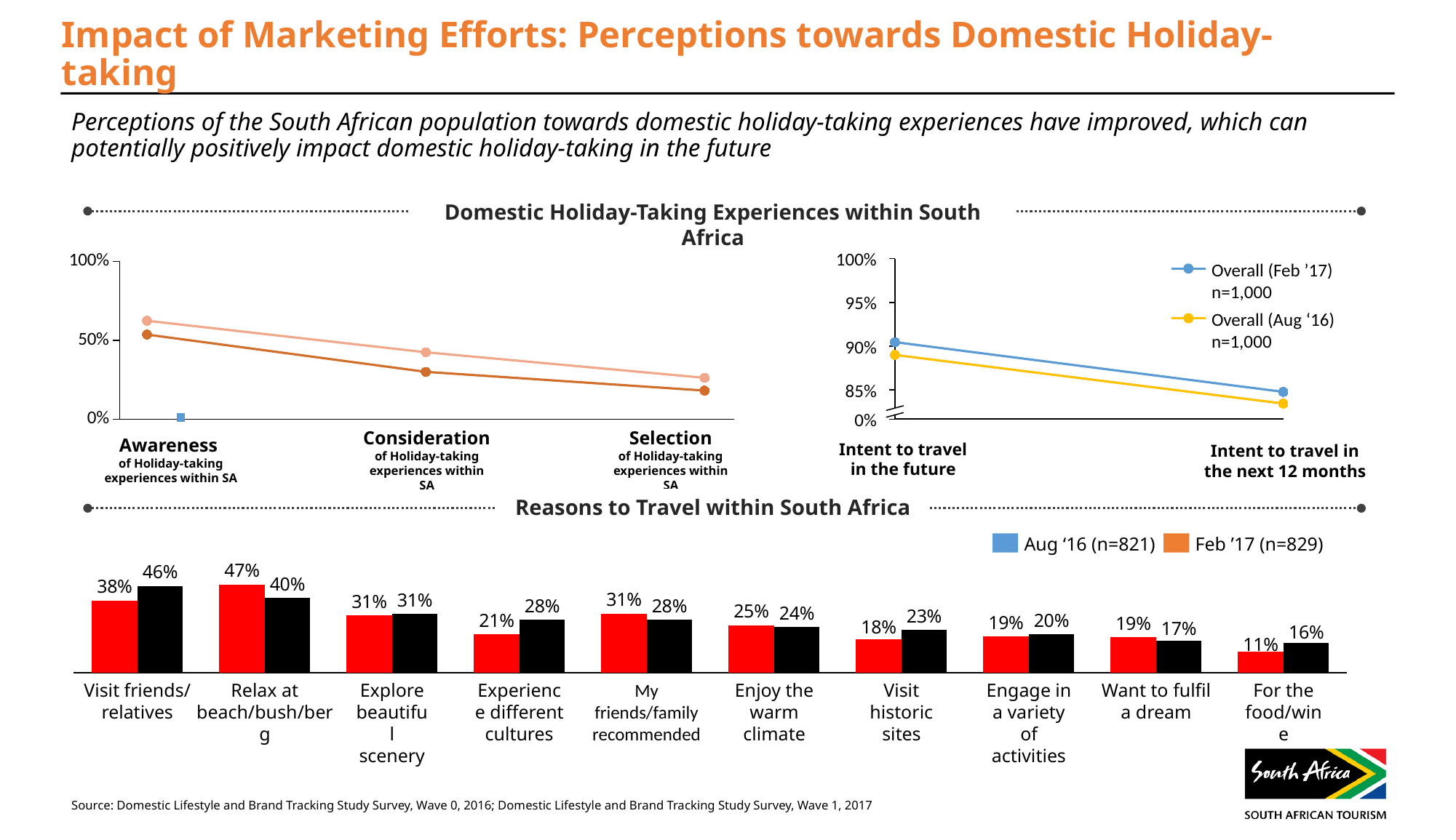
What is the title of the top section containing the two line charts? Domestic Holiday-Taking Experiences within South Africa How many series does the legend of the Reasons to Travel within South Africa chart list? 2 In the top-left chart, do the values rise or fall from Awareness to Selection? Fall In the Reasons to Travel within South Africa chart, what is the Aug '16 value for Relax at beach/bush/berg? 47% In the top-right chart, is the Overall (Aug '16) value for Intent to travel in the future greater or less than 90%? less In the Reasons to Travel within South Africa chart, is the Aug '16 or the Feb '17 value larger for Visit historic sites? Feb '17 In the Reasons to Travel within South Africa chart, what is the difference between the Feb '17 and Aug '16 values for Experience different cultures? 7% In the top-right chart, which series is higher for Intent to travel in the future, Overall (Feb '17) or Overall (Aug '16)? Overall (Feb '17) In the Reasons to Travel within South Africa chart, which reason has the lowest Aug '16 value? For the food/wine In the Reasons to Travel within South Africa chart, what is the Feb '17 value for Visit friends/relatives? 46% What kind of chart is the Reasons to Travel within South Africa chart? Bar chart How many reasons are shown in the Reasons to Travel within South Africa chart? 10